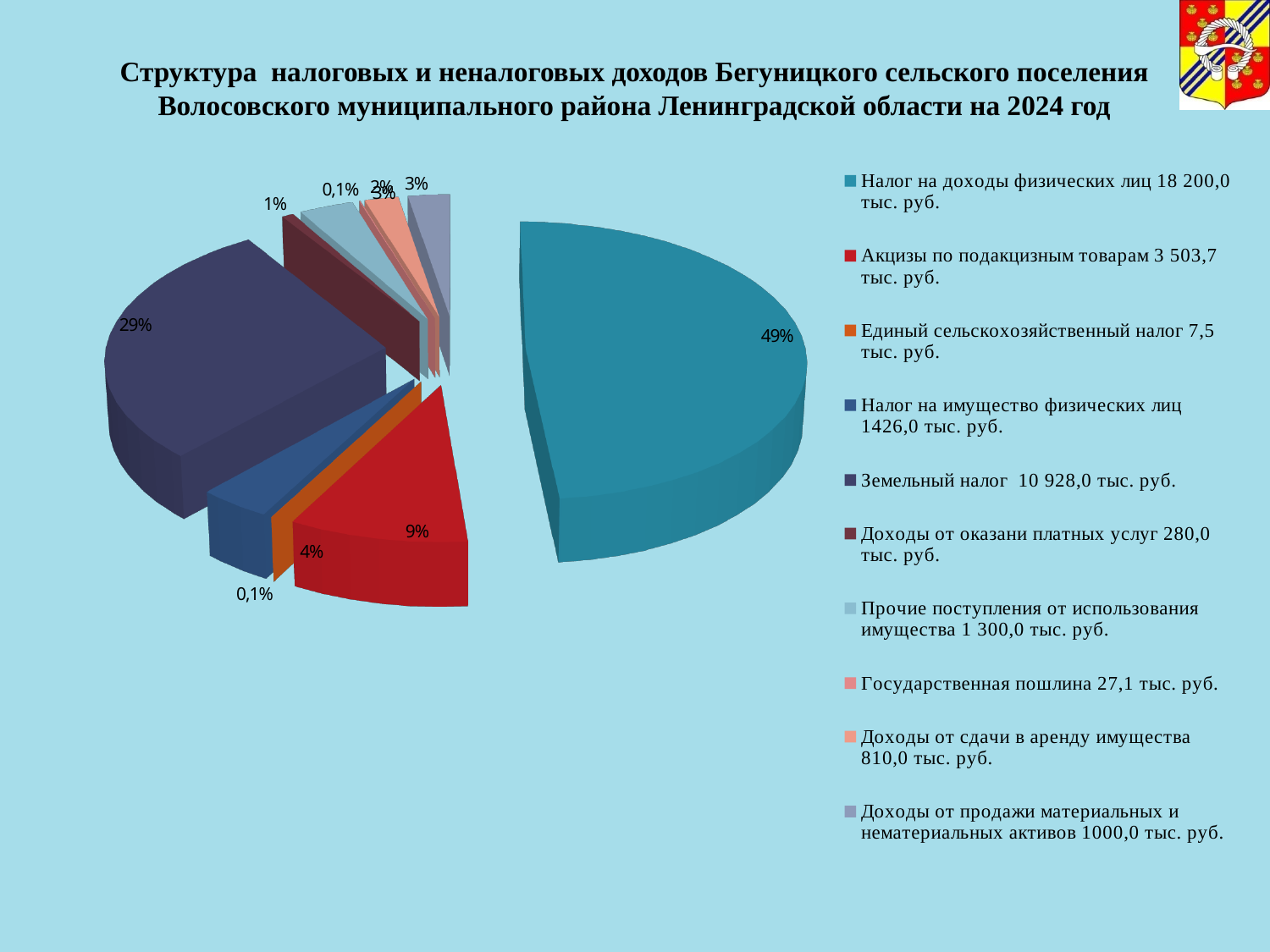
What kind of chart is shown on the slide? Pie chart By how much does Налог на доходы физических лиц (18 200,0 тыс. руб.) exceed Земельный налог (10 928,0 тыс. руб.) according to the legend? 7 272,0 тыс. руб. What amount does the legend give for Земельный налог? 10 928,0 тыс. руб. How many categories does the legend of the pie chart list? 10 Which is larger according to the legend: Доходы от сдачи в аренду имущества or Доходы от продажи материальных и нематериальных активов? Доходы от продажи материальных и нематериальных активов For which year does the chart title say the revenue structure is shown? 2024 What share of the pie does Земельный налог have? 29% What share of the pie does Налог на доходы физических лиц have? 49% What share of the pie does Налог на имущество физических лиц have? 4% What amount does the legend give for Государственная пошлина? 27,1 тыс. руб. Which category has the largest share of the pie? Налог на доходы физических лиц